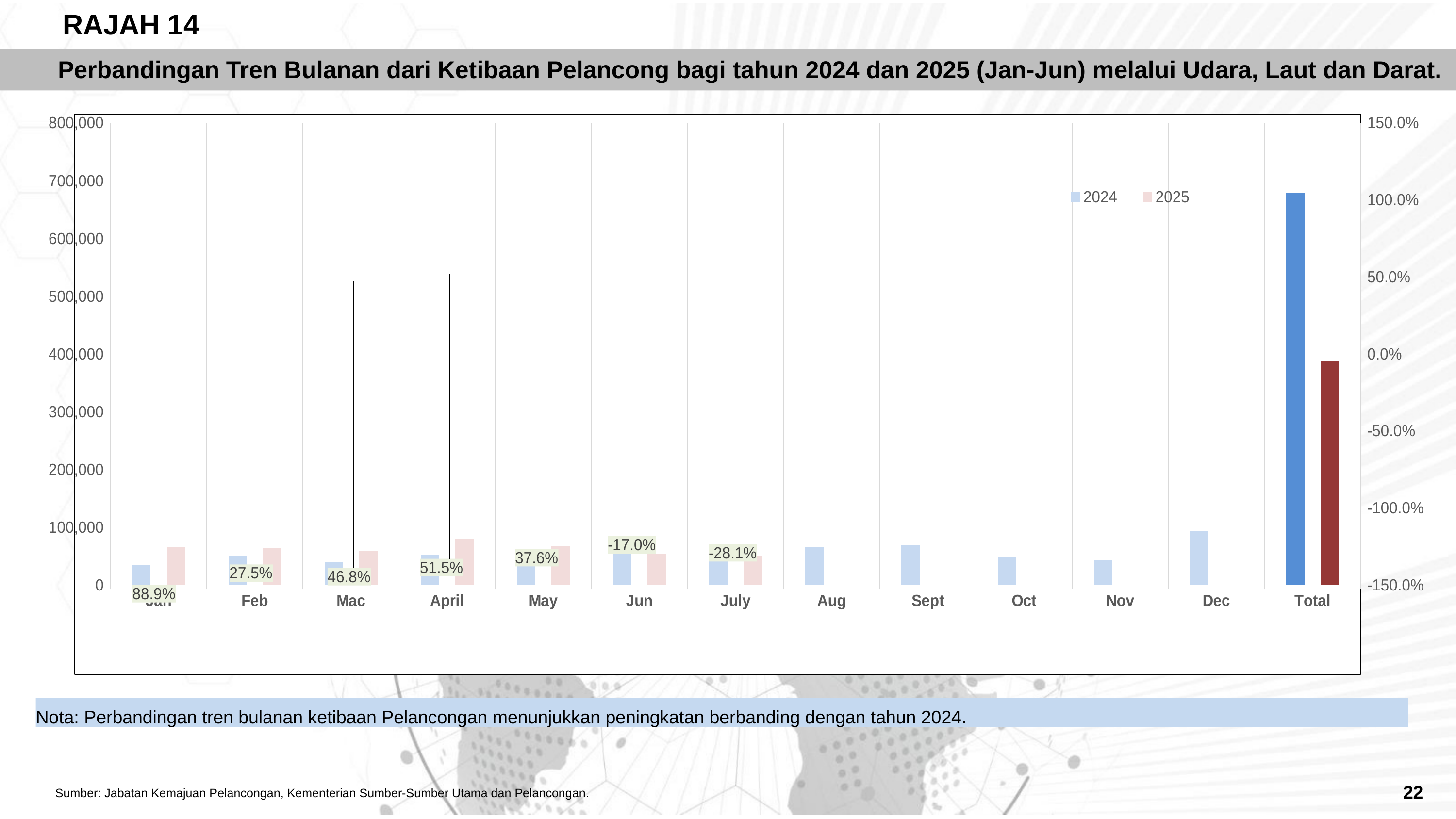
What is the difference between the labelled percentage changes for Jan and Feb? 61.4% Which has the larger labelled percentage change, Mac or April? April What percentage change is labelled for April? 51.5% How many series does the legend list? 2 Do the labelled percentage changes rise or fall from April to July? Fall Which month has the lowest labelled percentage change? July Is the 2024 value for Total greater or less than 600,000? greater What percentage change is labelled for Jun? -17.0% Which month has the highest labelled percentage change? Jan What percentage change is labelled for July? -28.1% What kind of chart is shown on the slide? Bar chart What percentage change is labelled for Jan? 88.9%